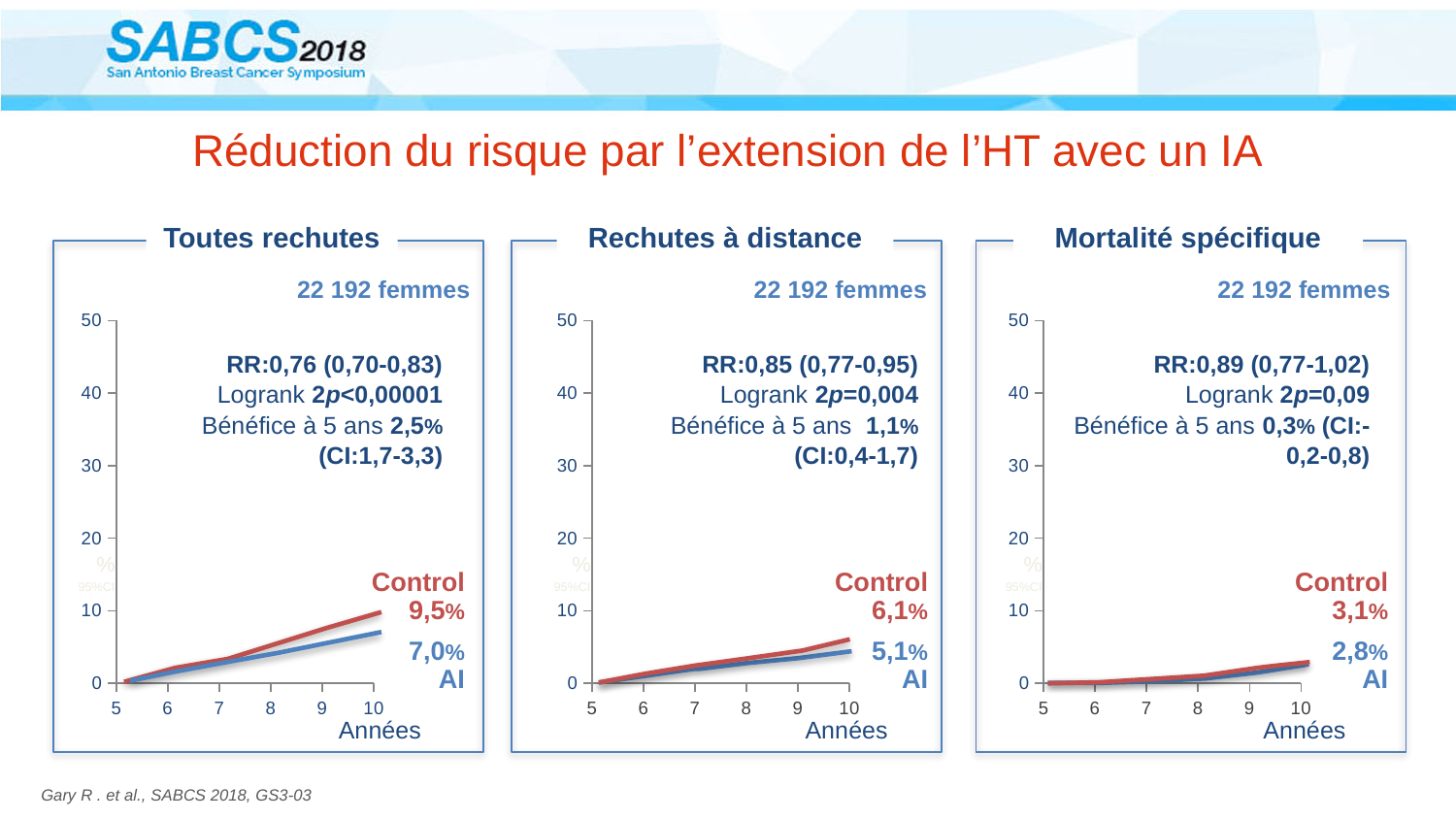
What kind of chart is the 'Rechutes à distance' chart? Line chart In the 'Rechutes à distance' chart, what is the difference between the Control and AI values at 10 years? 1,0% What is the title of the leftmost chart on the slide? Toutes rechutes In the 'Mortalité spécifique' chart, which is larger at 10 years, Control or AI? Control In the 'Toutes rechutes' chart, what is the value for Control at 10 years? 9,5% In the 'Toutes rechutes' chart, what is the difference between the Control and AI values at 10 years? 2,5% How many series are plotted in the 'Mortalité spécifique' chart? 2 In the 'Toutes rechutes' chart, what is the value for AI at 10 years? 7,0% In the 'Toutes rechutes' chart, is the Control value at 10 years greater or less than 10? less In the 'Mortalité spécifique' chart, what is the value for AI at 10 years? 2,8% In the 'Toutes rechutes' chart, do the values rise or fall from year 5 to year 10? Rise In the 'Rechutes à distance' chart, what is the value for Control at 10 years? 6,1%